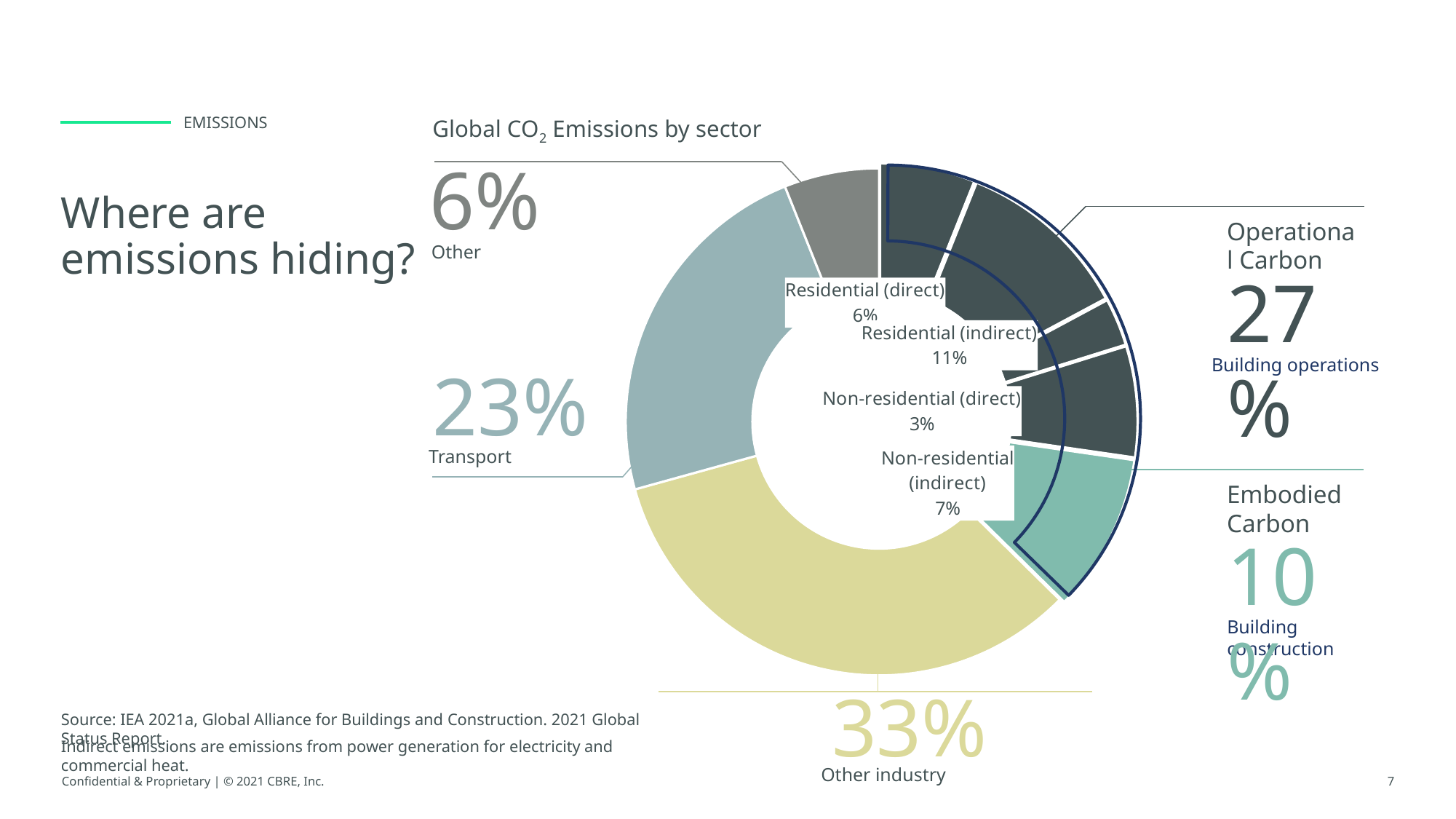
What share of global CO2 emissions does Transport account for? 23% What kind of chart is shown on the slide? Donut (pie) chart Which sector has the largest share of global CO2 emissions? Other industry Which sector has the smallest share of global CO2 emissions? Non-residential (direct) What percentage is shown for Operational Carbon (Building operations)? 27% What is the difference between the Other industry share and the Transport share? 10 percentage points What is the value shown for Non-residential (indirect)? 7% What is the value shown for Residential (indirect)? 11% What is the title of the chart on the slide? Global CO2 Emissions by sector Which is larger, the share for Residential (indirect) or the share for Non-residential (indirect)? Residential (indirect) What share of global CO2 emissions does Other industry account for? 33% What is the value shown for Non-residential (direct)? 3%